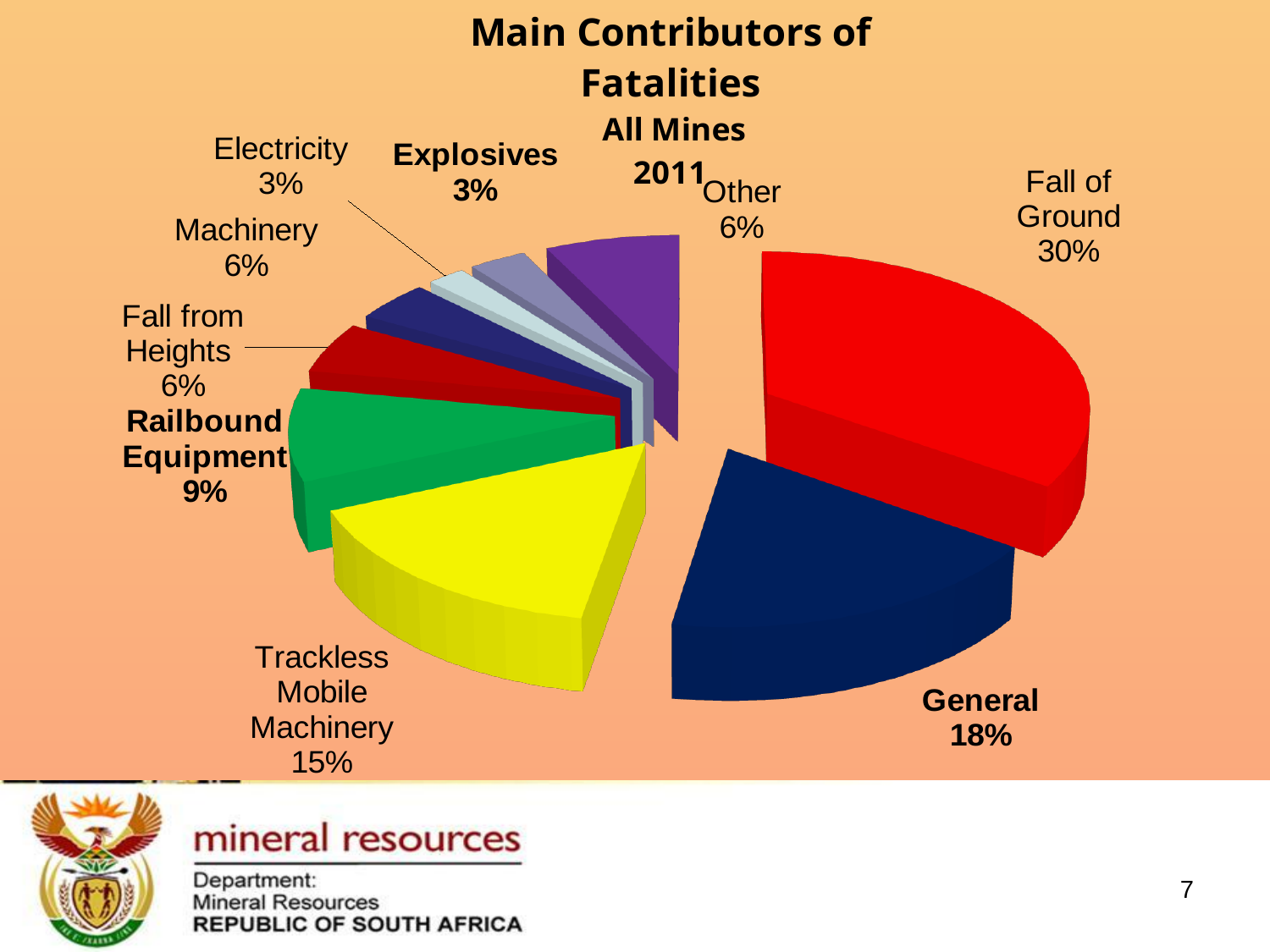
How many categories are shown in the pie chart? 9 What kind of chart is shown on the slide? pie chart Which category is the largest contributor to fatalities? Fall of Ground What percentage is shown for Fall from Heights? 6% What is the difference in percentage points between Fall of Ground and General? 12% What percentage is shown for General? 18% What percentage is shown for Trackless Mobile Machinery? 15% What is the title of the chart? Main Contributors of Fatalities All Mines 2011 What percentage is shown for Explosives? 3% What percentage is shown for Railbound Equipment? 9% What share of fatalities is attributed to Fall of Ground? 30% Which is larger, Trackless Mobile Machinery or Railbound Equipment? Trackless Mobile Machinery